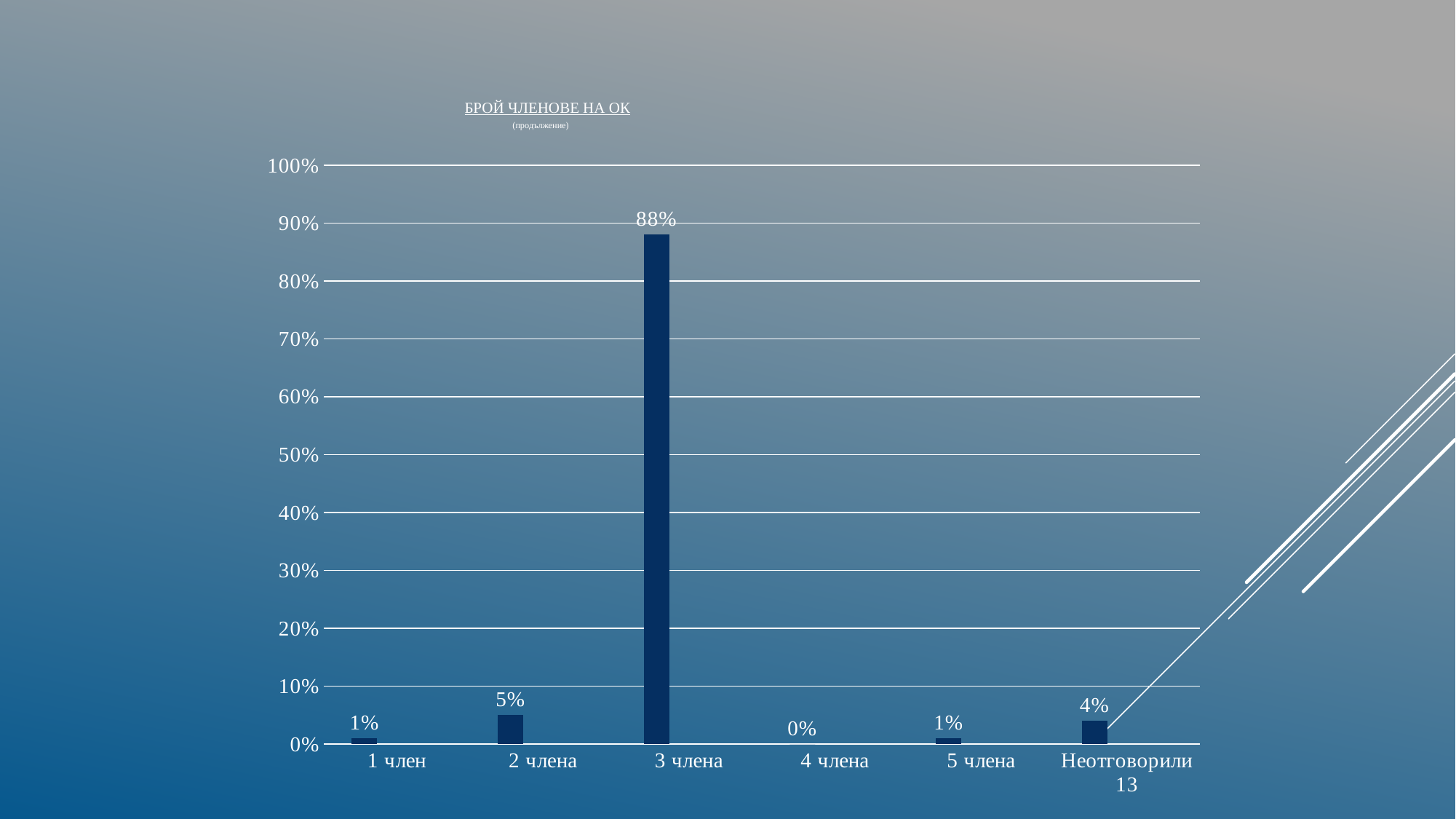
Which category has the highest value? 3 члена How many categories are shown on the x axis? 6 What is the value for 4 члена? 0% What is the value for Неотговорили 13? 4% What is the value for 3 члена? 88% Which is larger, the value for 2 члена or the value for Неотговорили 13? 2 члена Is the value for 3 члена greater or less than 80%? greater Which category has the lowest value? 4 члена What kind of chart is shown on the slide? bar chart What is the value for 2 члена? 5% What is the difference between the values for 3 члена and 2 члена? 83% What is the title of the chart? БРОЙ ЧЛЕНОВЕ НА ОК